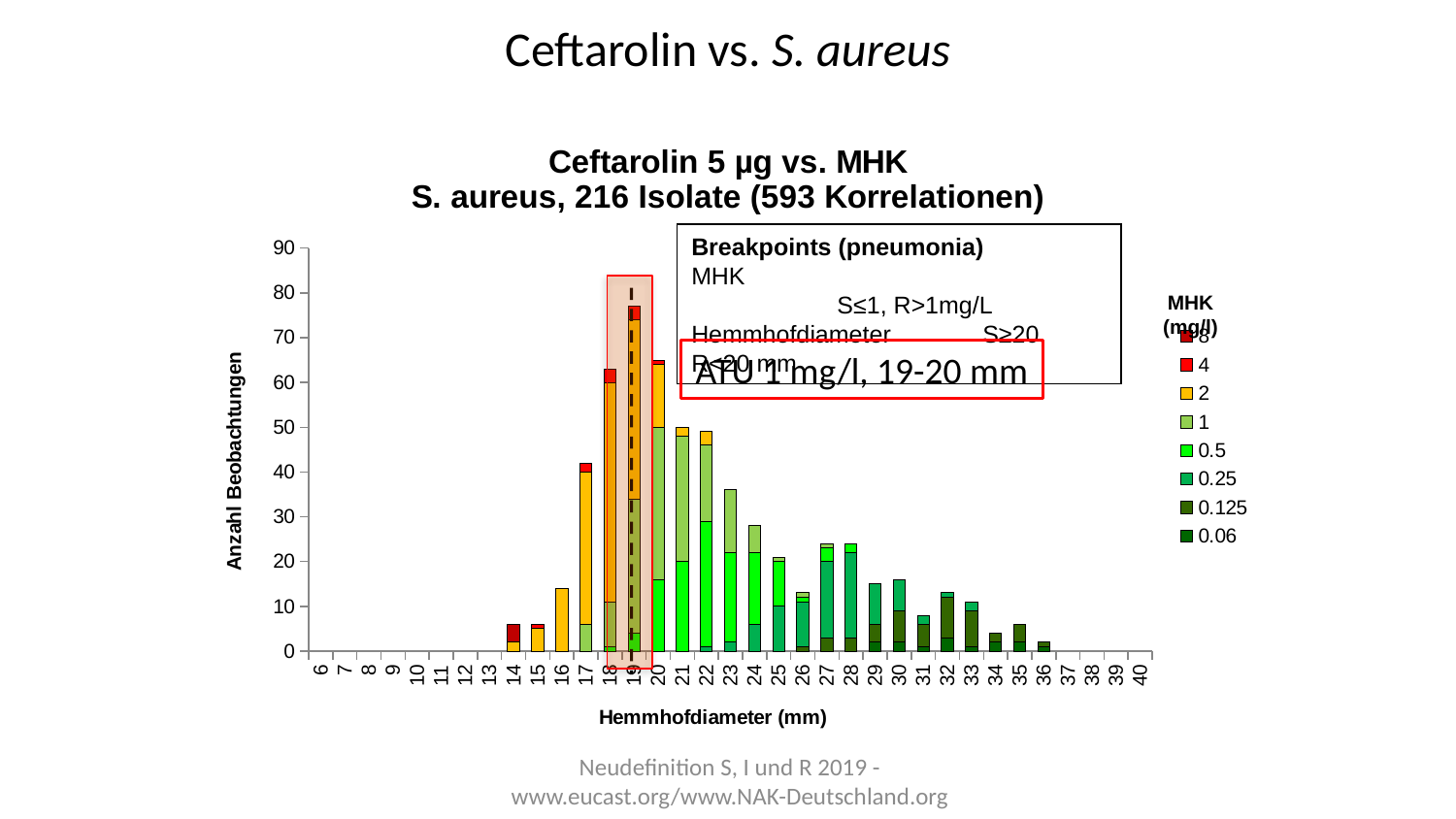
Is the total number of observations at 19 mm greater or less than 70? greater Is the total number of observations at 23 mm greater or less than 30? greater What is the title of the x axis? Hemmhofdiameter (mm) Which has more observations in total: 19 mm or 20 mm? 19 mm Is the total number of observations at 20 mm greater or less than 60? greater What kind of chart is shown on the slide? Stacked bar chart Do the total observations rise or fall as the Hemmhofdiameter increases from 19 mm to 36 mm? fall Which has more observations in total: 16 mm or 17 mm? 17 mm At which Hemmhofdiameter (mm) is the total number of observations highest? 19 How many series does the legend (MHK mg/l) list? 8